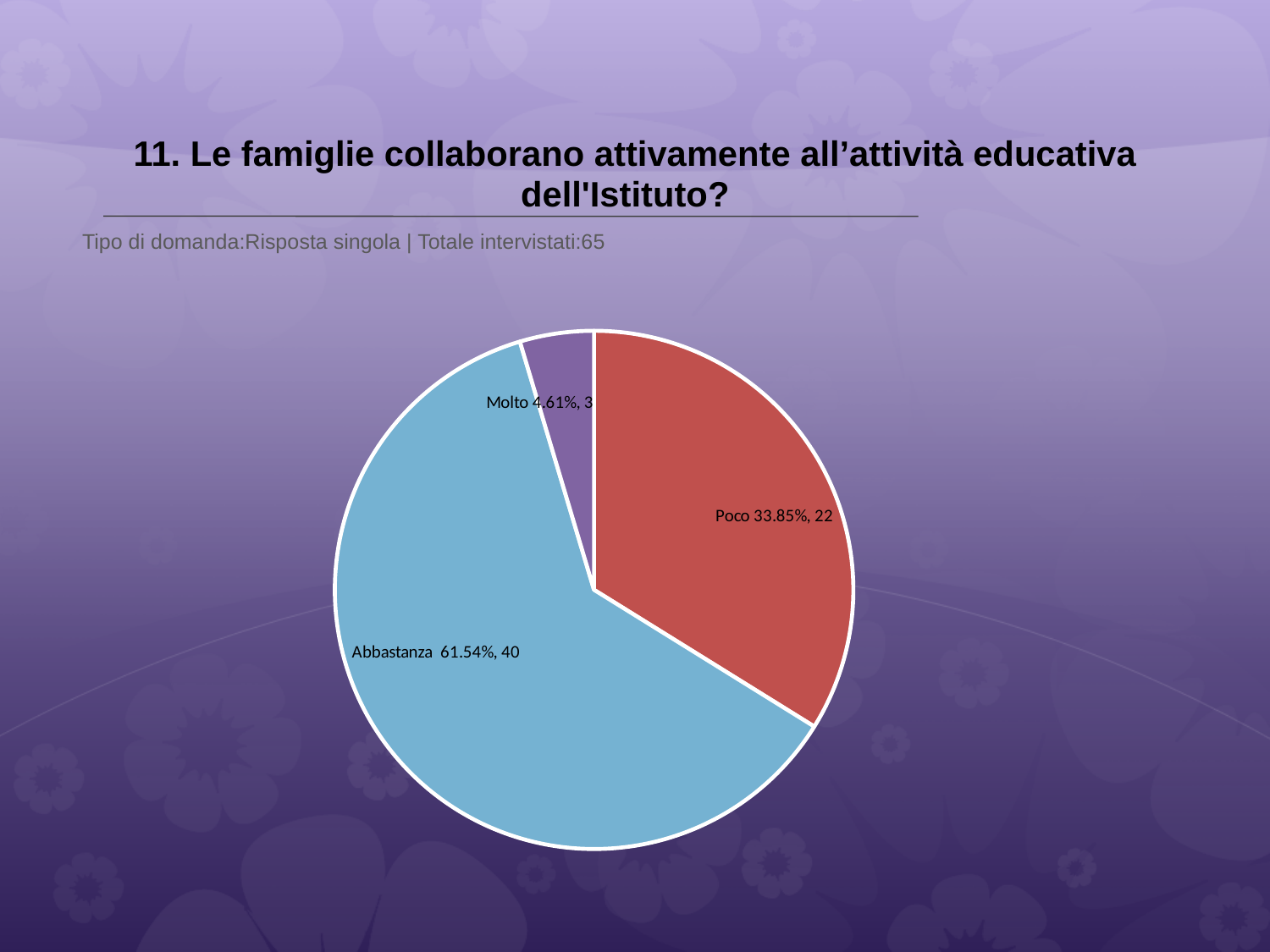
Which response has the largest slice of the pie? Abbastanza How many respondents answered Poco? 22 How many respondents answered Molto? 3 What percentage share does the Molto slice have? 4.61% What percentage share does the Abbastanza slice have? 61.54% What is the difference in respondent count between Abbastanza and Poco? 18 How many slices does the pie chart have? 3 How many respondents answered Abbastanza? 40 Which slice is larger, Poco or Molto? Poco Which response has the smallest slice of the pie? Molto What percentage share does the Poco slice have? 33.85% What kind of chart is shown on the slide? pie chart